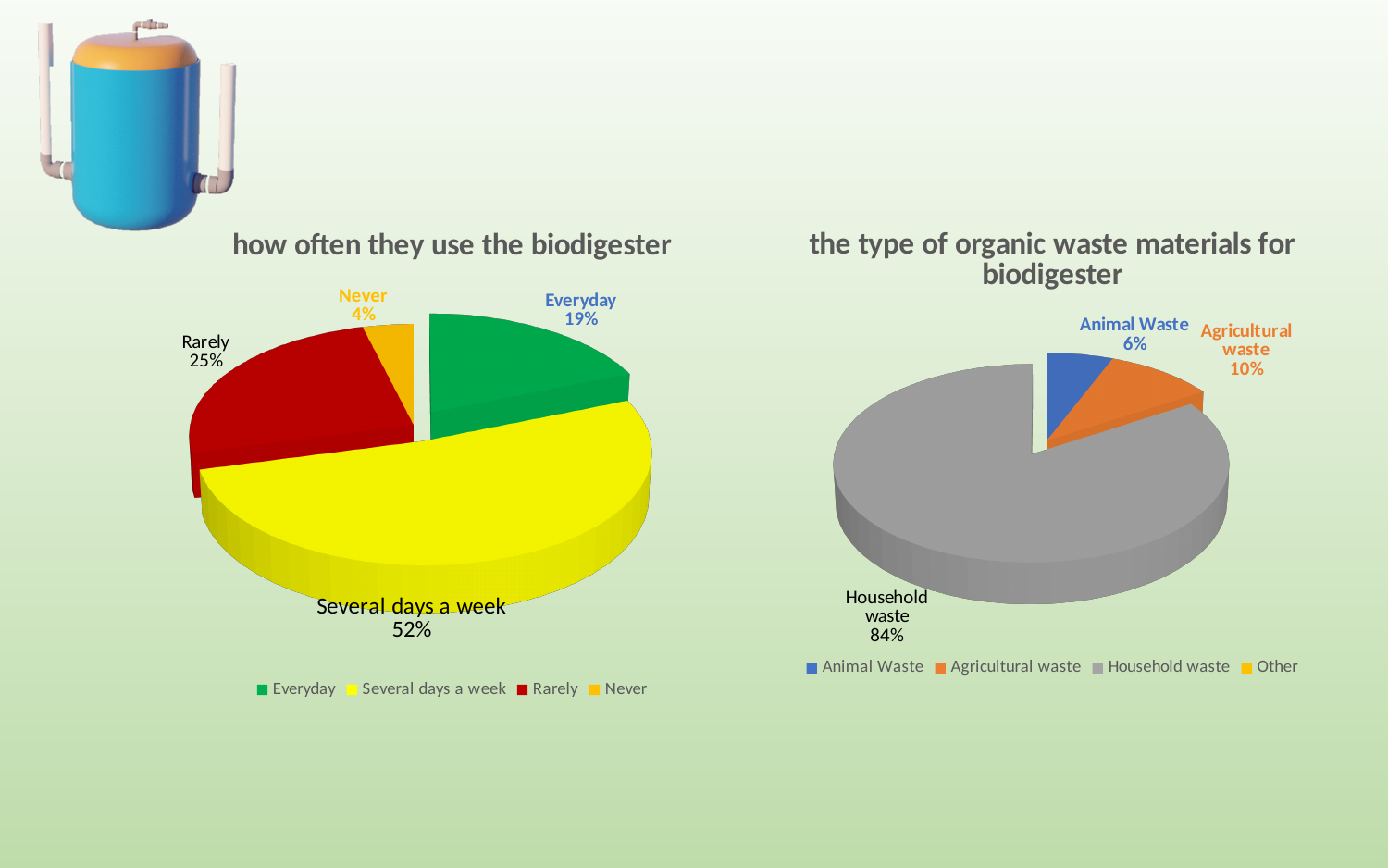
In the chart titled "how often they use the biodigester", what is the difference in percentage points between Rarely and Everyday? 6 In the chart titled "how often they use the biodigester", which category has the smallest share? Never In the chart titled "how often they use the biodigester", what is the value for Rarely? 25% In the chart titled "the type of organic waste materials for biodigester", what colour is the Household waste slice? Grey In the chart titled "how often they use the biodigester", what percentage of respondents use the biodigester several days a week? 52% In the chart titled "the type of organic waste materials for biodigester", what is the share for Household waste? 84% In the chart titled "how often they use the biodigester", how many categories are shown in the legend? 4 In the chart titled "how often they use the biodigester", which category has the largest share? Several days a week In the chart titled "the type of organic waste materials for biodigester", what is the difference in percentage points between Agricultural waste and Animal Waste? 4 In the chart titled "how often they use the biodigester", which is larger, Everyday or Rarely? Rarely What type of chart is the chart titled "the type of organic waste materials for biodigester"? Pie chart In the chart titled "the type of organic waste materials for biodigester", what is the value for Animal Waste? 6%